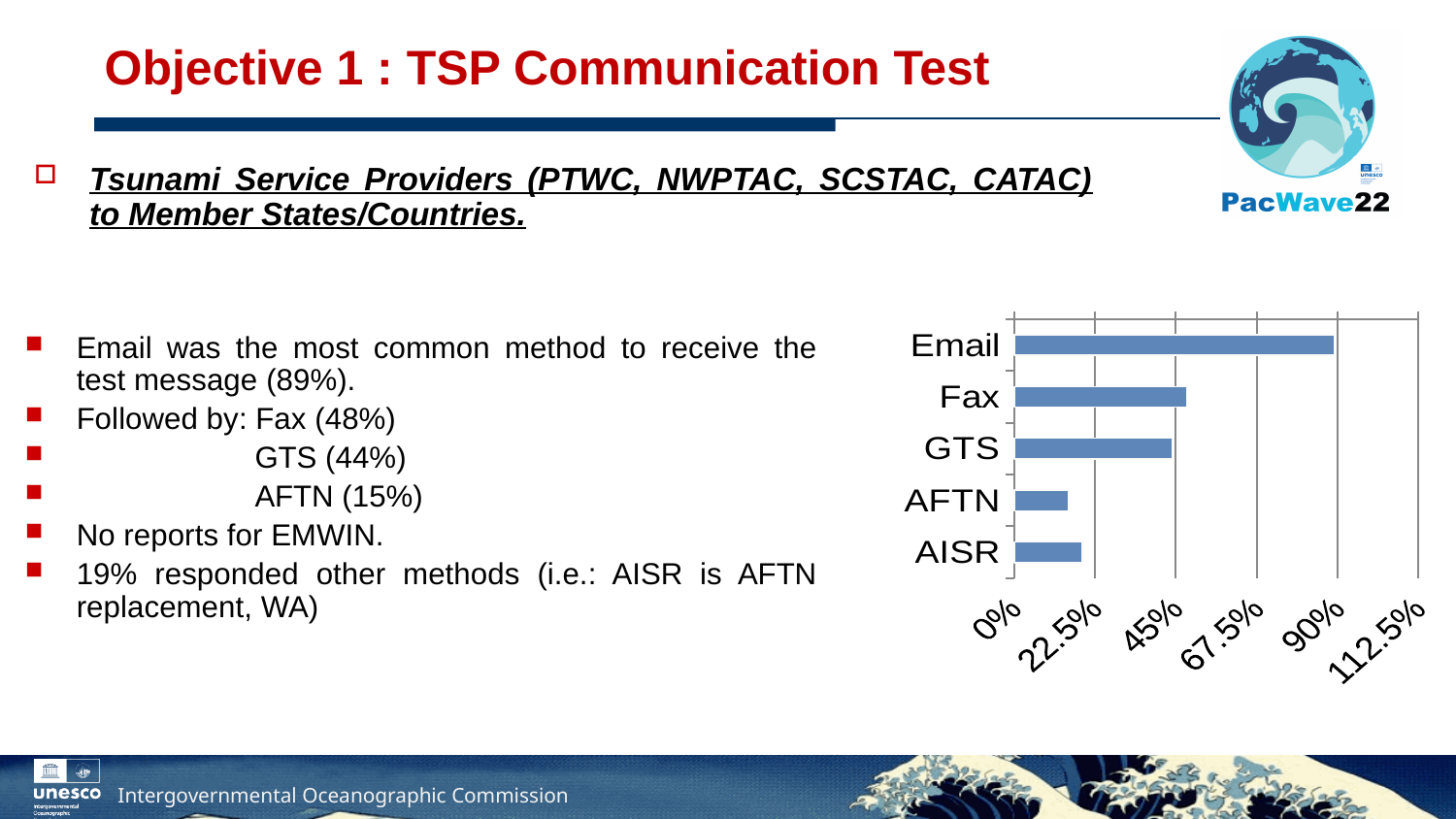
Which has the larger value in the chart, AFTN or AISR? AISR What is the highest tick label shown on the value axis of the chart? 112.5% What kind of chart is shown on the slide? bar chart Which has the larger value in the chart, Email or Fax? Email Which category has the longest bar in the chart? Email Is the value for Email greater or less than 67.5%? greater Which category has the shortest bar in the chart? AFTN Is the value for AISR greater or less than 22.5%? less Is the value for GTS greater or less than 22.5%? greater How many categories are shown on the chart? 5